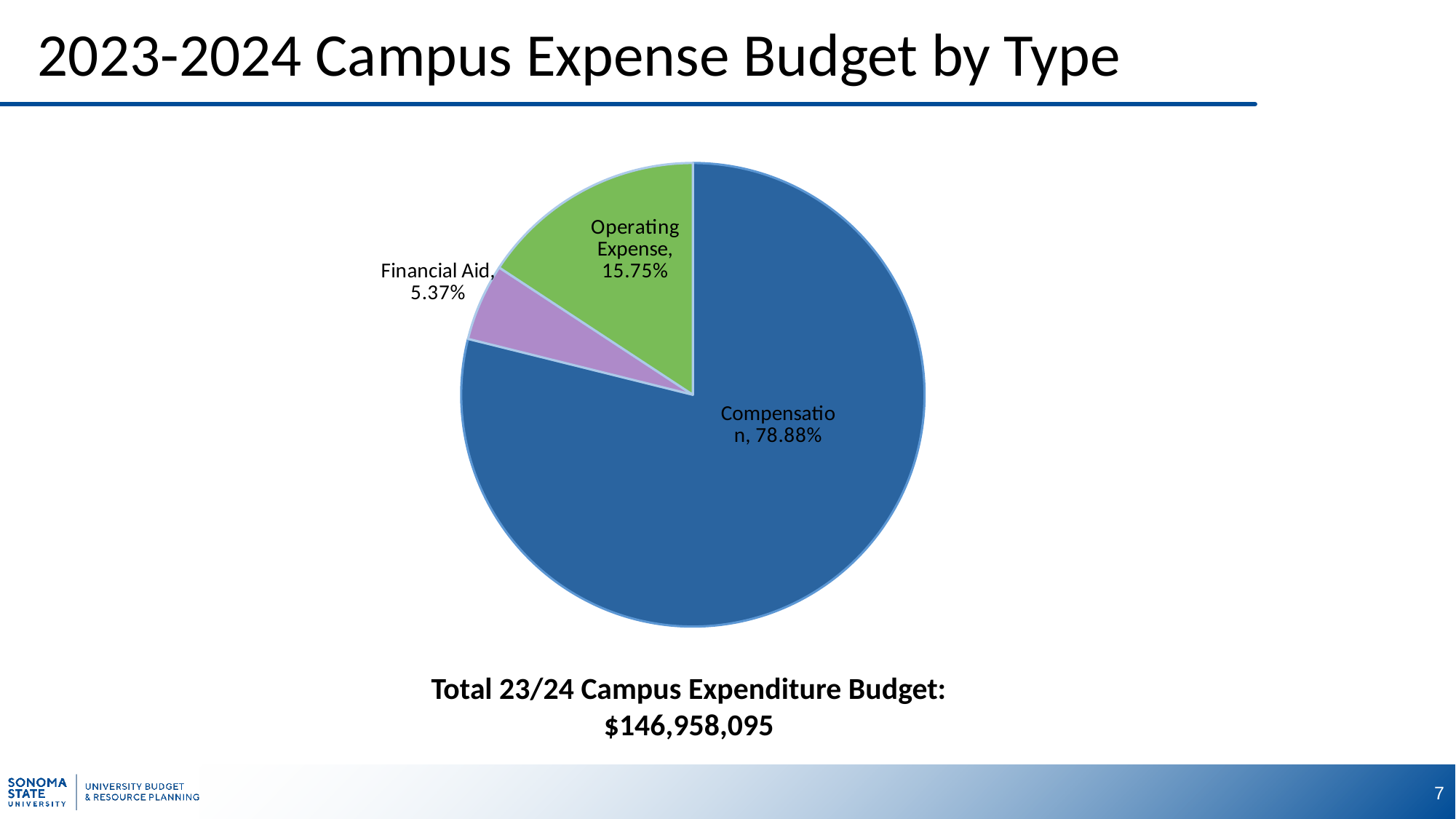
What colour is the Financial Aid slice? purple What share of the budget is Operating Expense? 15.75% What is the difference in percentage points between the Compensation share and the Operating Expense share? 63.13 Which is larger, the share for Operating Expense or the share for Financial Aid? Operating Expense What is the difference in percentage points between the Operating Expense share and the Financial Aid share? 10.38 Which expense type has the largest share of the budget? Compensation Which expense type has the smallest share of the budget? Financial Aid What kind of chart is shown on the slide? pie chart What share of the budget is Compensation? 78.88% How many slices does the pie chart have? 3 What share of the budget is Financial Aid? 5.37% What is the total 23/24 campus expenditure budget stated below the chart? $146,958,095